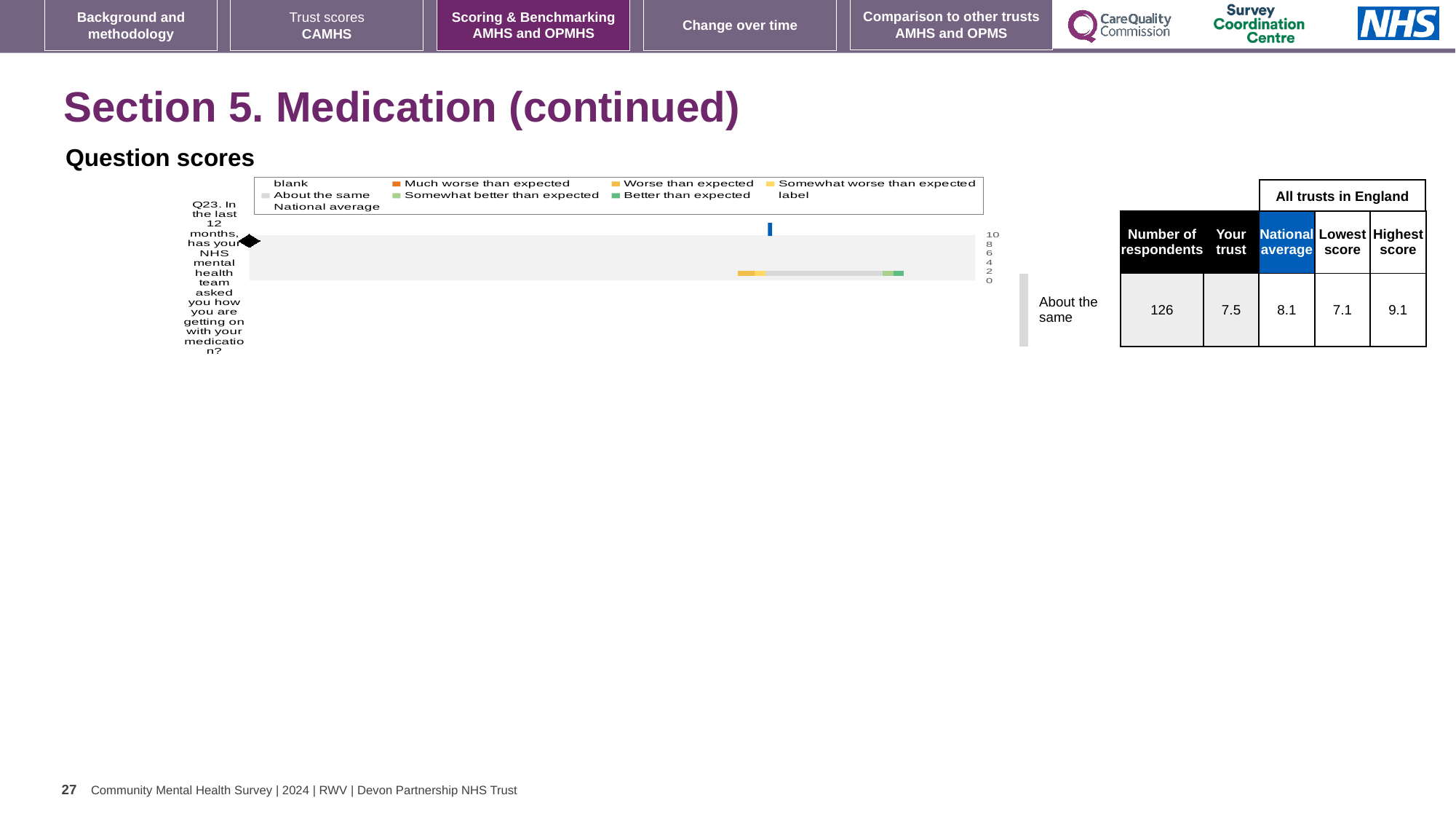
What is the highest value shown on the chart's axis? 10 Which question number is plotted in the chart? Q23 What kind of chart is shown on the slide? bar chart In the table next to the chart, what is the national average for Q23? 8.1 What is the difference between the highest score and the lowest score for Q23 in the table? 2.0 In the table next to the chart, what is the lowest score across all trusts in England for Q23? 7.1 How many entries does the chart's legend list? 9 In the table next to the chart, what is the 'Your trust' score for Q23? 7.5 In the table next to the chart, what is the number of respondents for Q23? 126 How many question categories are plotted in the chart? 1 Which is larger for Q23, the 'Your trust' score or the national average? national average In the table next to the chart, what is the highest score across all trusts in England for Q23? 9.1